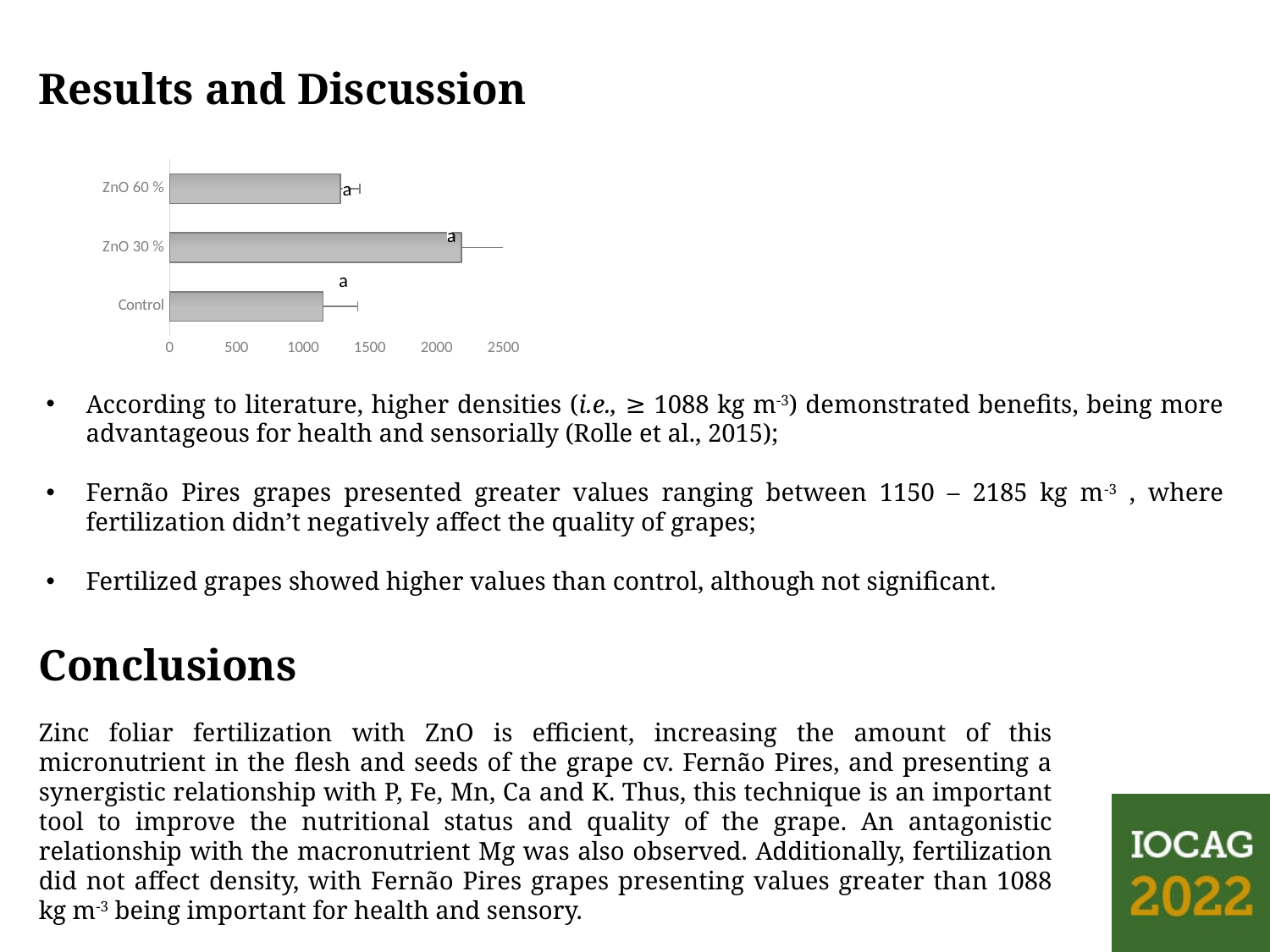
Is the value for ZnO 30 % greater or less than 2000? greater What letter is printed next to each bar in the chart? a Is the value for ZnO 60 % greater or less than 1500? less Which is larger, the value for ZnO 30 % or the value for Control? ZnO 30 % Which is larger, the value for ZnO 30 % or the value for ZnO 60 %? ZnO 30 % Which category has the highest value in the bar chart? ZnO 30 % How many categories are plotted in the bar chart? 3 What kind of chart is shown on the slide? bar chart Is the value for ZnO 60 % greater or less than 1000? greater What is the highest tick value shown on the x axis of the bar chart? 2500